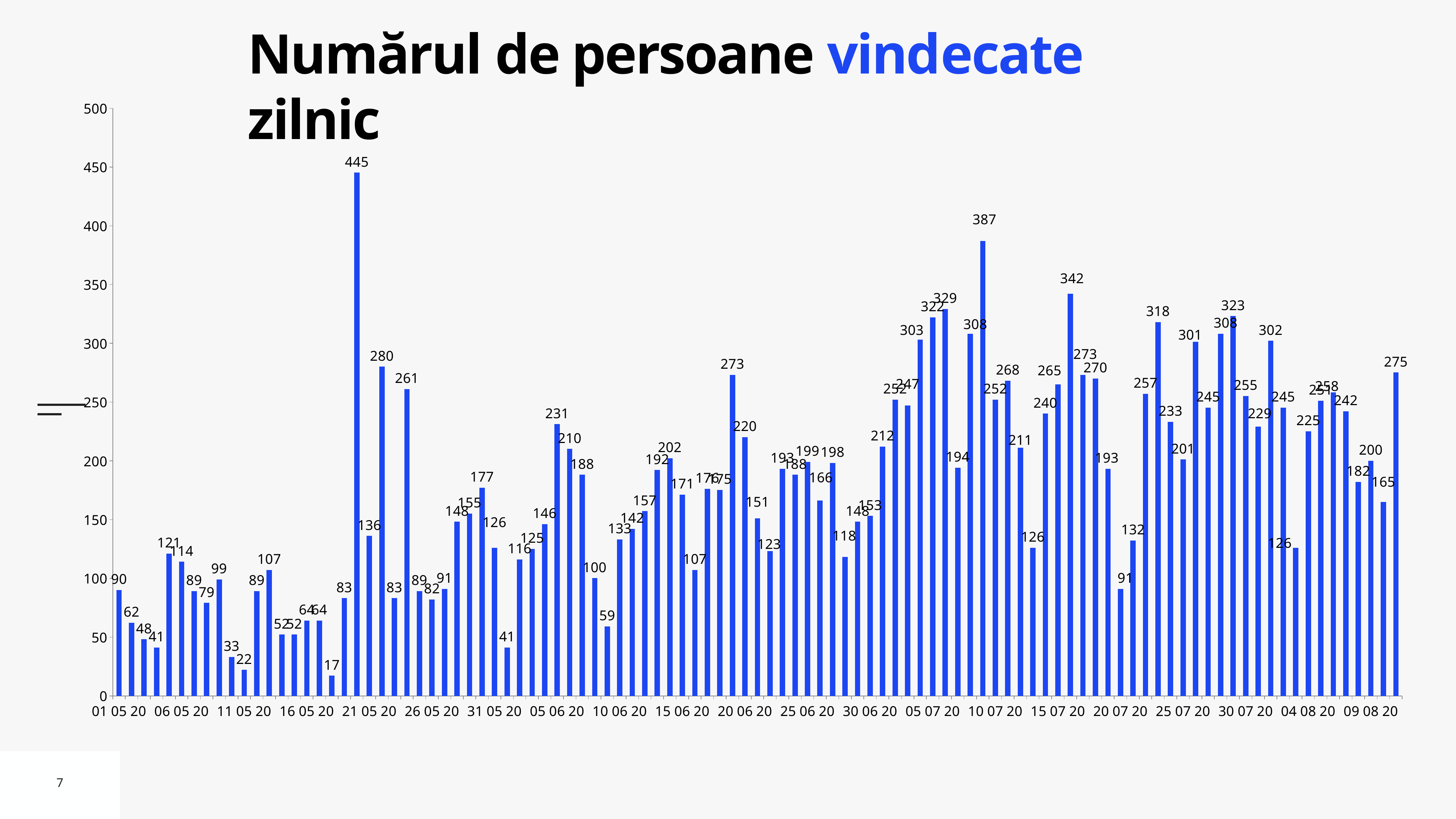
What is the lowest daily value shown in the chart? 17 Do the daily values generally rise or fall from the start of the chart (May) to the end (August)? rise What is the highest daily value shown in the chart? 445 What is the value for 01 05 20, the first bar in the chart? 90 What kind of chart is shown on the slide? bar chart What is the second highest value shown in the chart? 387 Is the value of the tallest bar greater or less than 400? greater Which is larger, the bar labelled 445 or the bar labelled 387? 445 What colour are the bars in the chart? blue What is the difference between the highest value (445) and the lowest value (17) in the chart? 428 Is the value of the shortest bar greater or less than 50? less What is the title of the chart? Numărul de persoane vindecate zilnic